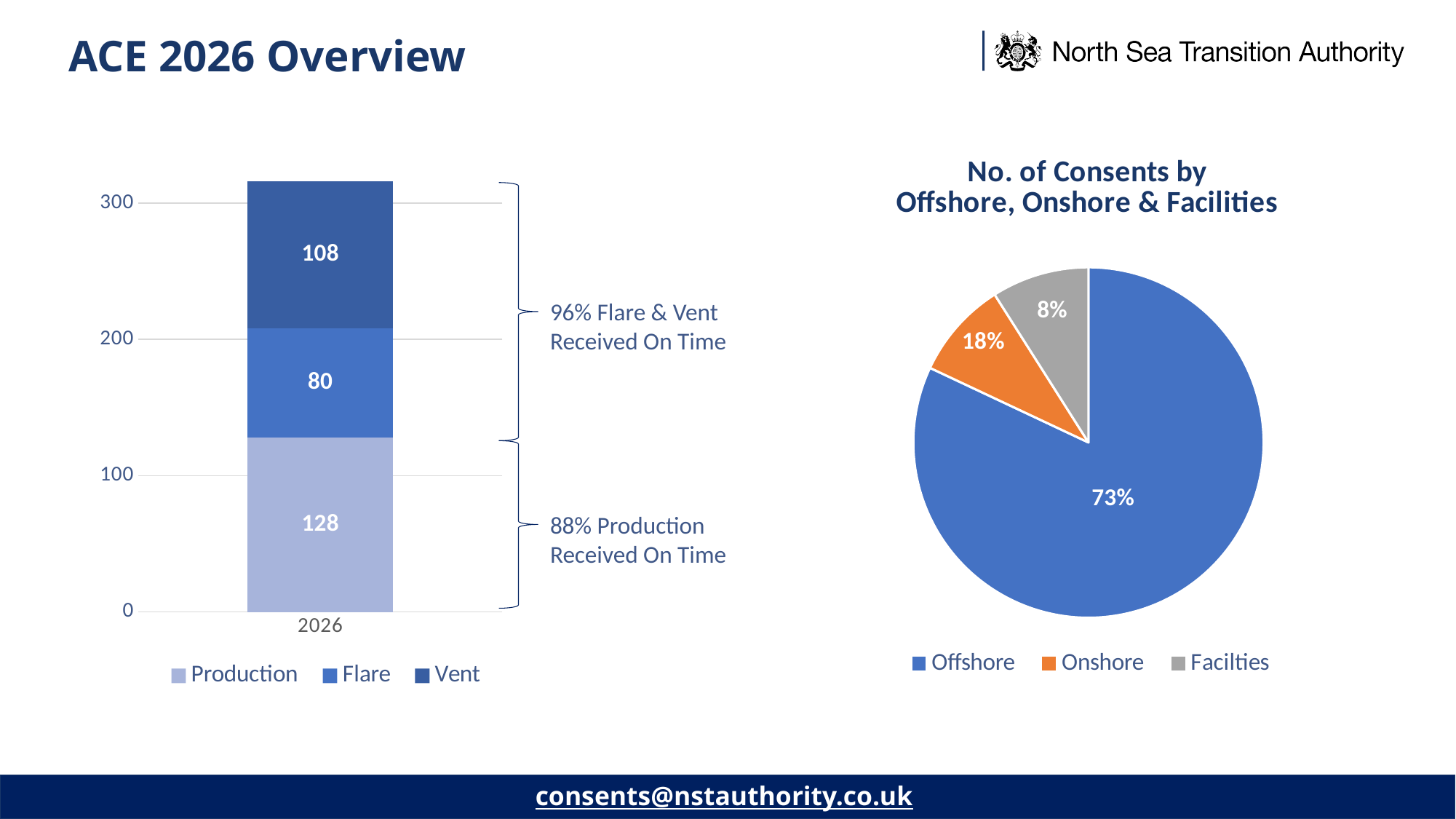
In the chart titled 'No. of Consents by Offshore, Onshore & Facilities', what share of the pie is Onshore? 18% In the chart titled 'No. of Consents by Offshore, Onshore & Facilities', which category has the smallest slice? Facilties In the stacked bar chart on the left, how many series does the legend list? 3 In the stacked bar chart on the left, what is the value for Vent in 2026? 108 In the chart titled 'No. of Consents by Offshore, Onshore & Facilities', what share of the pie is Offshore? 73% In the stacked bar chart on the left, which series has the smallest value in 2026? Flare In the stacked bar chart on the left, what is the difference between the Production and Vent values? 20 In the stacked bar chart on the left, what is the total of the 2026 bar? 316 In the stacked bar chart on the left, what is the value for Production in 2026? 128 In the stacked bar chart on the left, what is the value for Flare in 2026? 80 What kind of chart is the chart on the right of the slide? Pie chart In the stacked bar chart on the left, which series has the largest value in 2026? Production